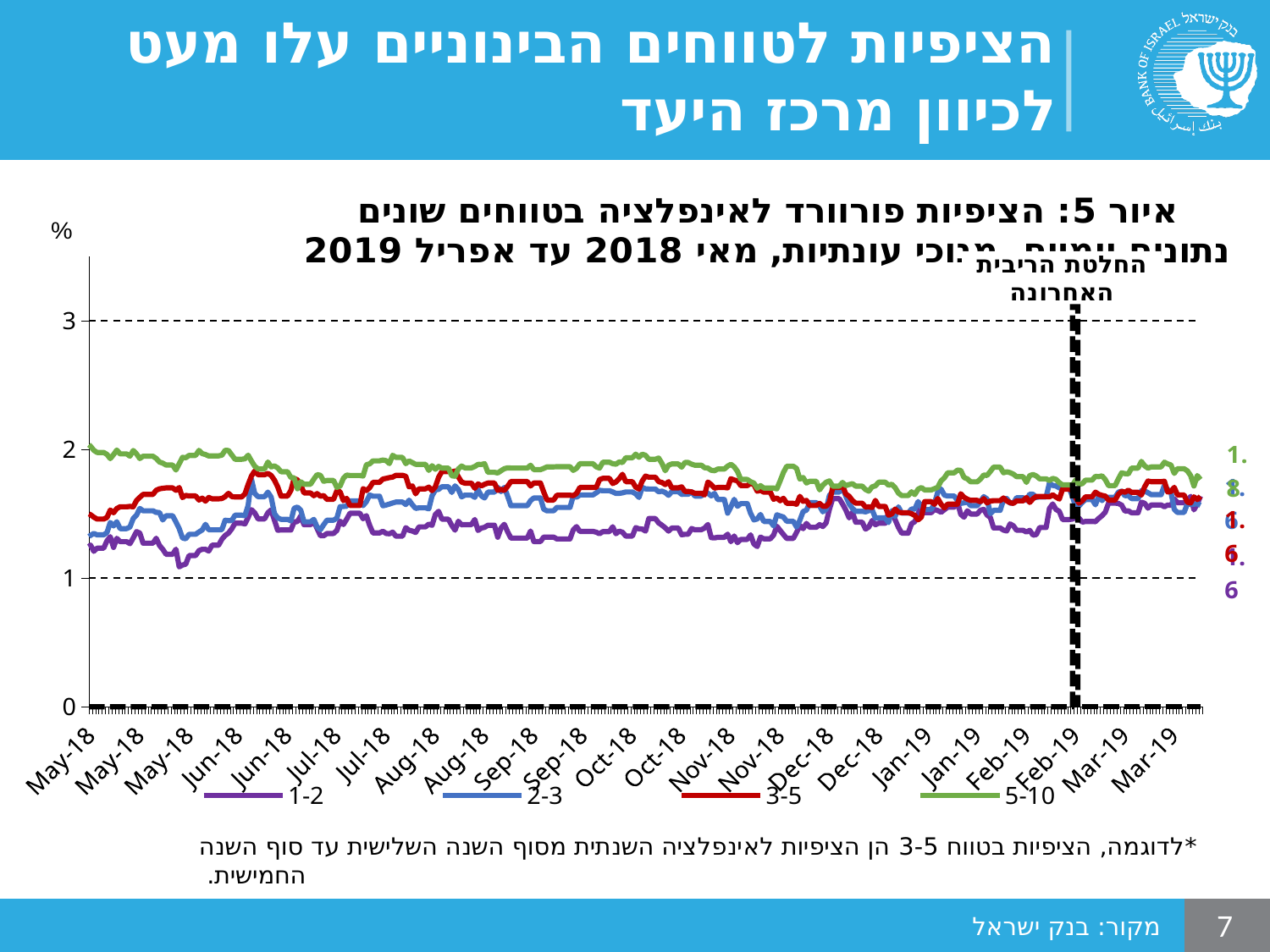
How many series does the legend list? 4 Which series has the lowest value at the start of the period (May-18)? 1-2 Does the 1-2 series rise or fall overall from May-18 to Mar-19? rise Is the value for the 1-2 series at May-18 greater or less than 2? less At Jun-18, which is larger: the 5-10 series or the 1-2 series? 5-10 Which series has the highest value at the start of the period (May-18)? 5-10 Is the value for the 5-10 series at Mar-19 greater or less than 3? less What does the label next to the vertical dashed line on the chart say? החלטת הריבית האחרונה What are the legend entries of the chart? 1-2, 2-3, 3-5, 5-10 Which series stays highest across the whole period shown? 5-10 Is the value for the 5-10 series at May-18 greater or less than 1? greater What kind of chart is shown on the slide? line chart